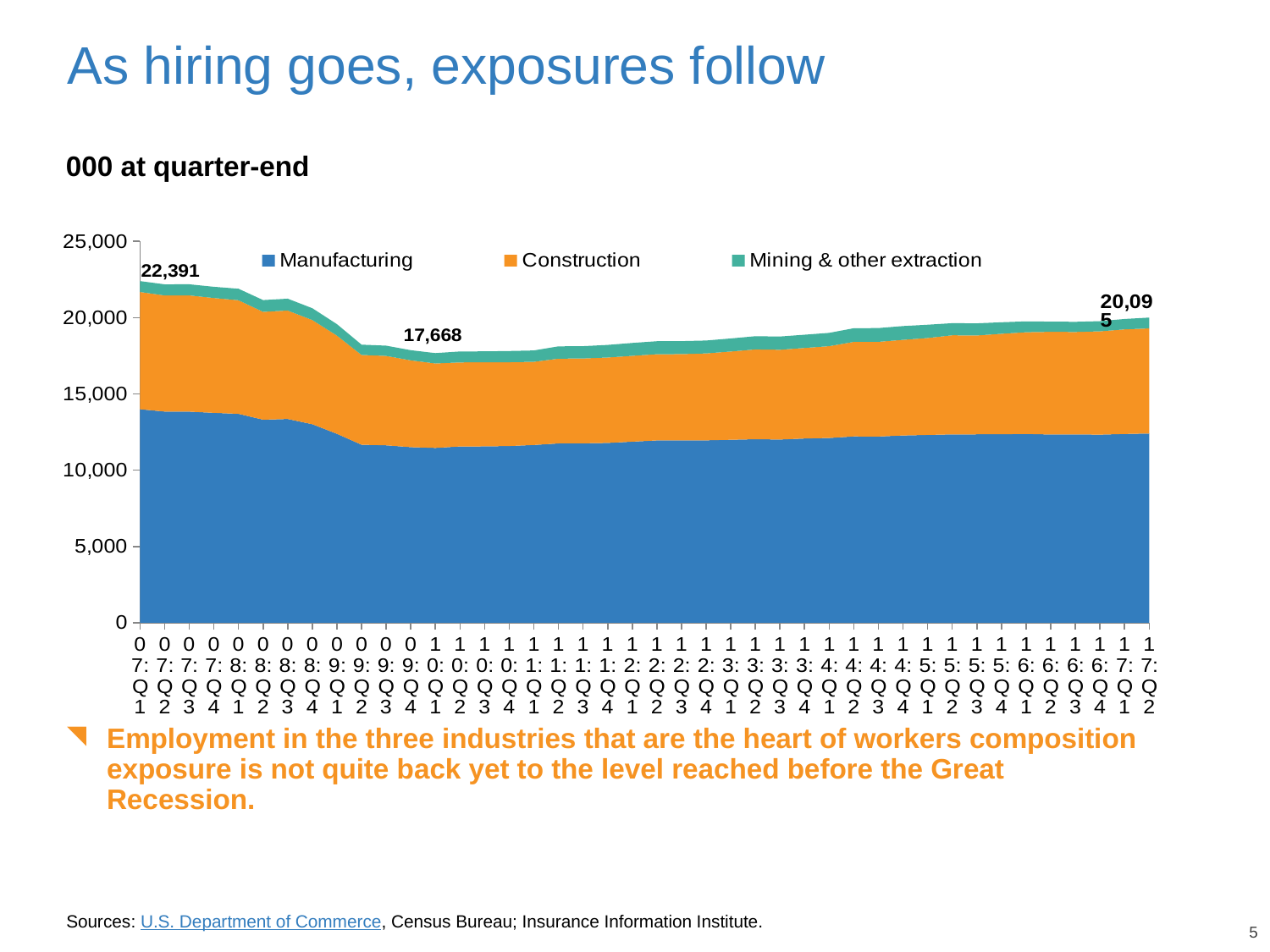
At 17:Q2, which series is larger, Manufacturing or Construction? Manufacturing Which three series are listed in the legend? Manufacturing, Construction, Mining & other extraction What is the lowest total value labeled on the chart? 17,668 What kind of chart is shown on the slide? Stacked area chart Is the Manufacturing value at 07:Q1 greater or less than 15,000? less What is the total employment value labeled at 07:Q1? 22,391 How many series does the legend list? 3 What is the difference between the labeled total at 07:Q1 (22,391) and the labeled total at 17:Q2 (20,095)? 2,296 What is the total employment value labeled at 17:Q2? 20,095 What is the difference between the labeled peak of 22,391 and the labeled trough of 17,668? 4,723 How does total employment trend from 07:Q1 to around 10:Q1? It falls Is the Manufacturing value at 17:Q2 greater or less than 10,000? greater